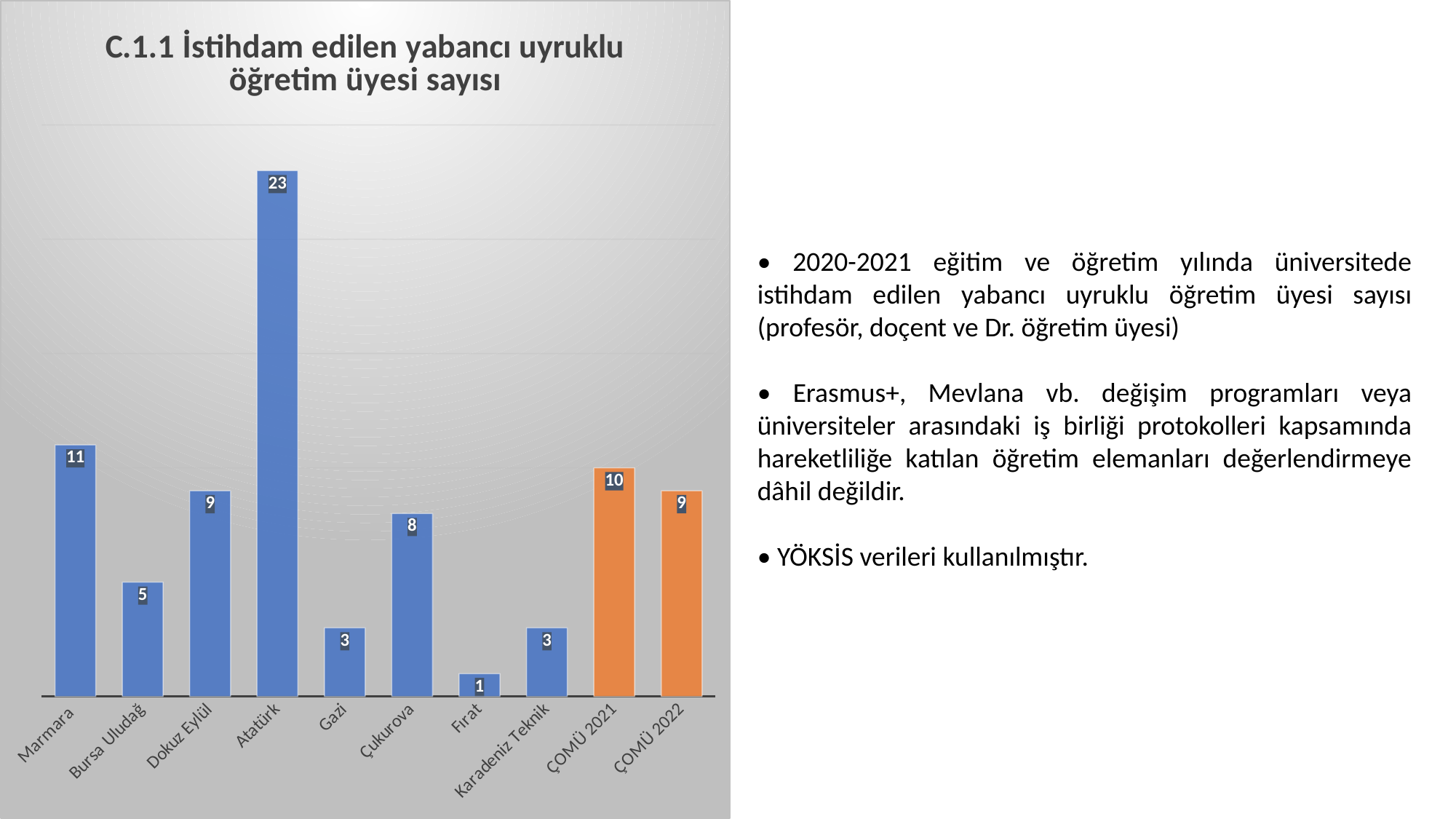
What kind of chart is shown on the slide? Bar chart What is the difference between the values for Atatürk and Marmara? 12 What is the value for ÇOMÜ 2021? 10 What is the value for Atatürk? 23 Which is larger, the value for Çukurova or the value for Dokuz Eylül? Dokuz Eylül Which category has the lowest value? Fırat What is the difference between the values for ÇOMÜ 2021 and ÇOMÜ 2022? 1 What is the value for Bursa Uludağ? 5 What is the title of the chart? C.1.1 İstihdam edilen yabancı uyruklu öğretim üyesi sayısı Which category has the highest value? Atatürk Which categories are shown with orange bars? ÇOMÜ 2021 and ÇOMÜ 2022 How many categories are shown on the x axis? 10